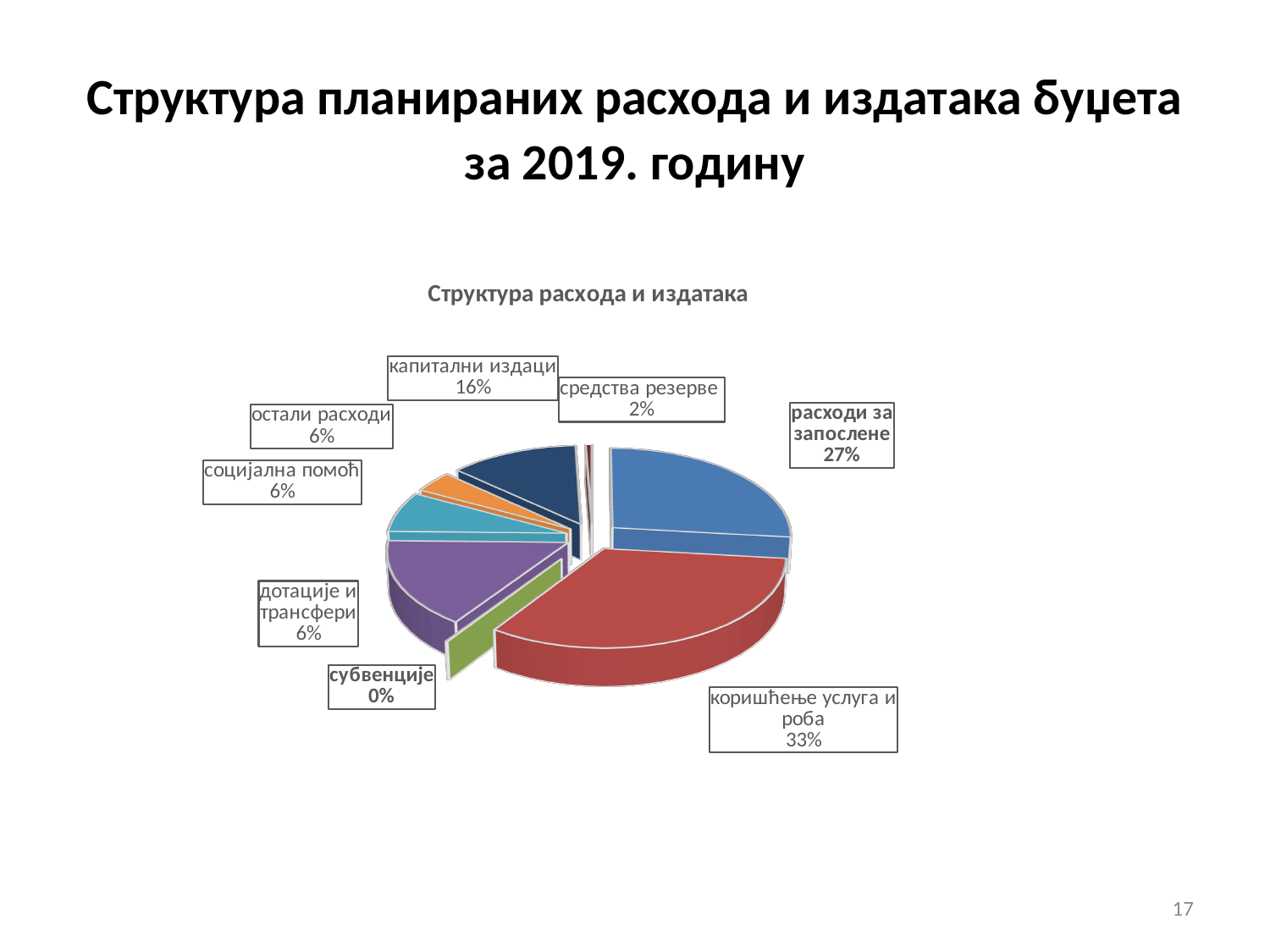
What share of the pie is субвенције? 0% What share of the pie is коришћење услуга и роба? 33% Which category has the largest share of the pie? коришћење услуга и роба What is the chart's title? Структура расхода и издатака What kind of chart is shown on the slide? pie chart What share of the pie is средства резерве? 2% Which is larger, the share of капитални издаци or the share of социјална помоћ? капитални издаци How many categories are shown in the pie chart? 8 What is the difference between the shares of коришћење услуга и роба and расходи за запослене? 6% Which category has the smallest share of the pie? субвенције